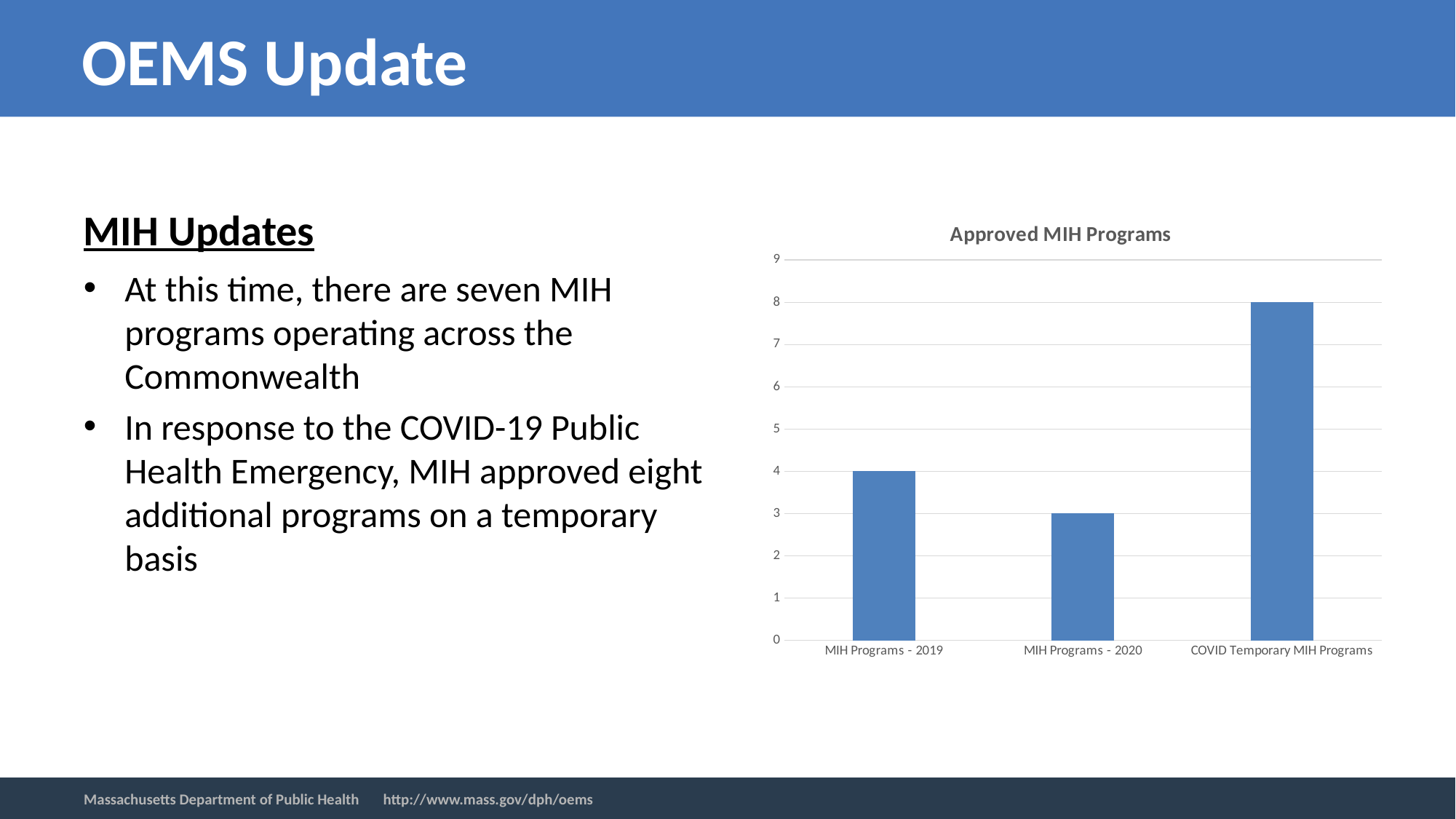
Which category has the lowest value in the Approved MIH Programs chart? MIH Programs - 2020 What is the difference between the MIH Programs - 2019 value and the MIH Programs - 2020 value? 1 What kind of chart is the Approved MIH Programs chart? bar chart What is the value for COVID Temporary MIH Programs in the Approved MIH Programs chart? 8 Is the value for COVID Temporary MIH Programs greater or less than 5? greater What is the value for MIH Programs - 2020 in the Approved MIH Programs chart? 3 What is the difference between the COVID Temporary MIH Programs value and the MIH Programs - 2019 value? 4 What is the title of the chart on the slide? Approved MIH Programs What is the value for MIH Programs - 2019 in the Approved MIH Programs chart? 4 How many categories are shown in the Approved MIH Programs chart? 3 Which category has the highest value in the Approved MIH Programs chart? COVID Temporary MIH Programs Which is larger, the value for MIH Programs - 2019 or the value for MIH Programs - 2020? MIH Programs - 2019